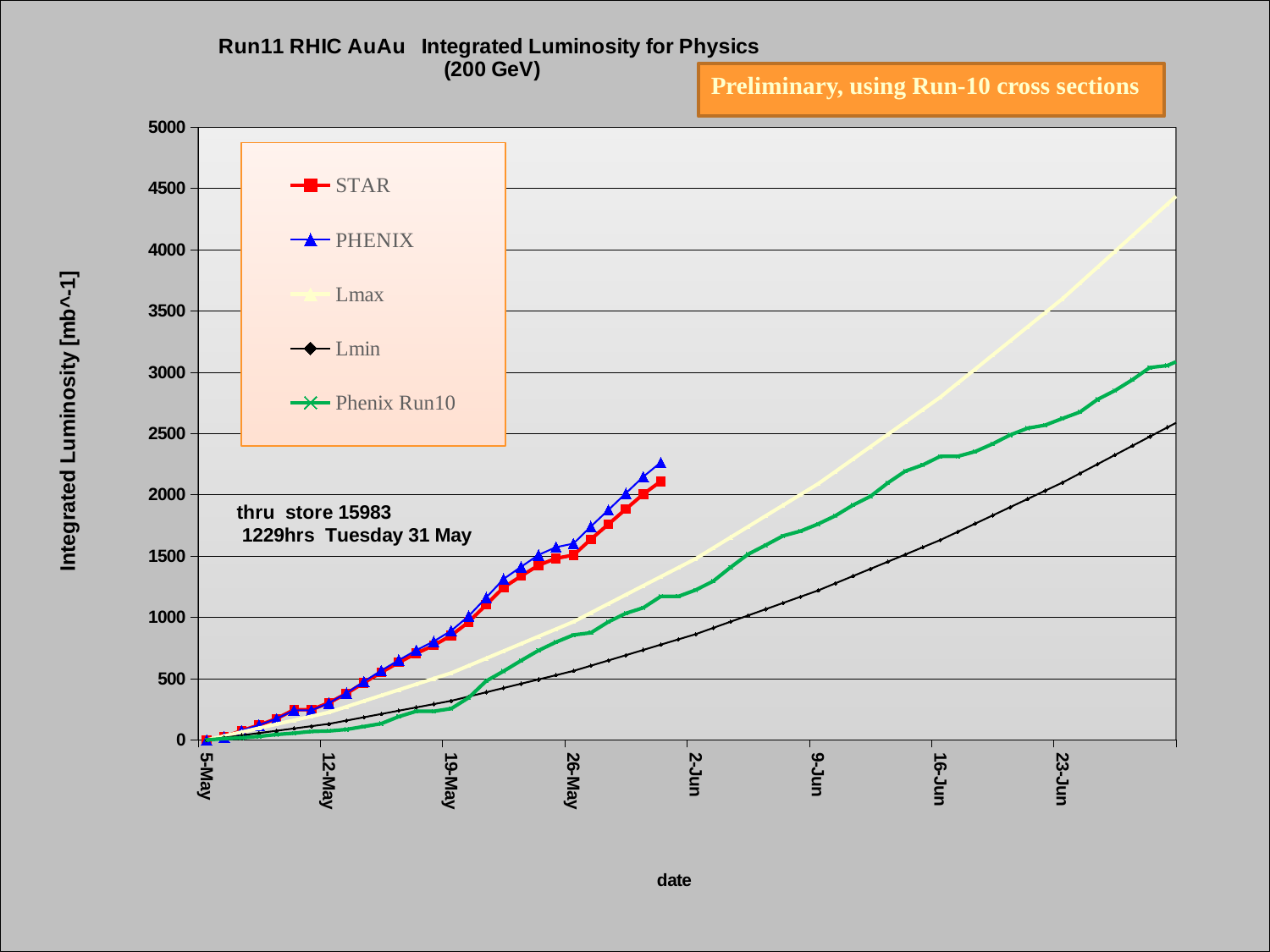
Is the value of the Lmax series at the right end of the chart greater or less than 4000? greater Is the last plotted value of the PHENIX series greater or less than 2000? greater Is the value of the Phenix Run10 series at 9-Jun greater or less than 1500? greater What is the label of the x axis? date At 23-Jun, which series has the lower value, Lmax or Lmin? Lmin What kind of chart is shown on the slide? line chart What is the label of the y axis? Integrated Luminosity [mb^-1] Do the values of the Lmin series rise or fall from 5-May to the right end of the chart? rise Which series reaches the highest value on the chart? Lmax How many series does the legend list? 5